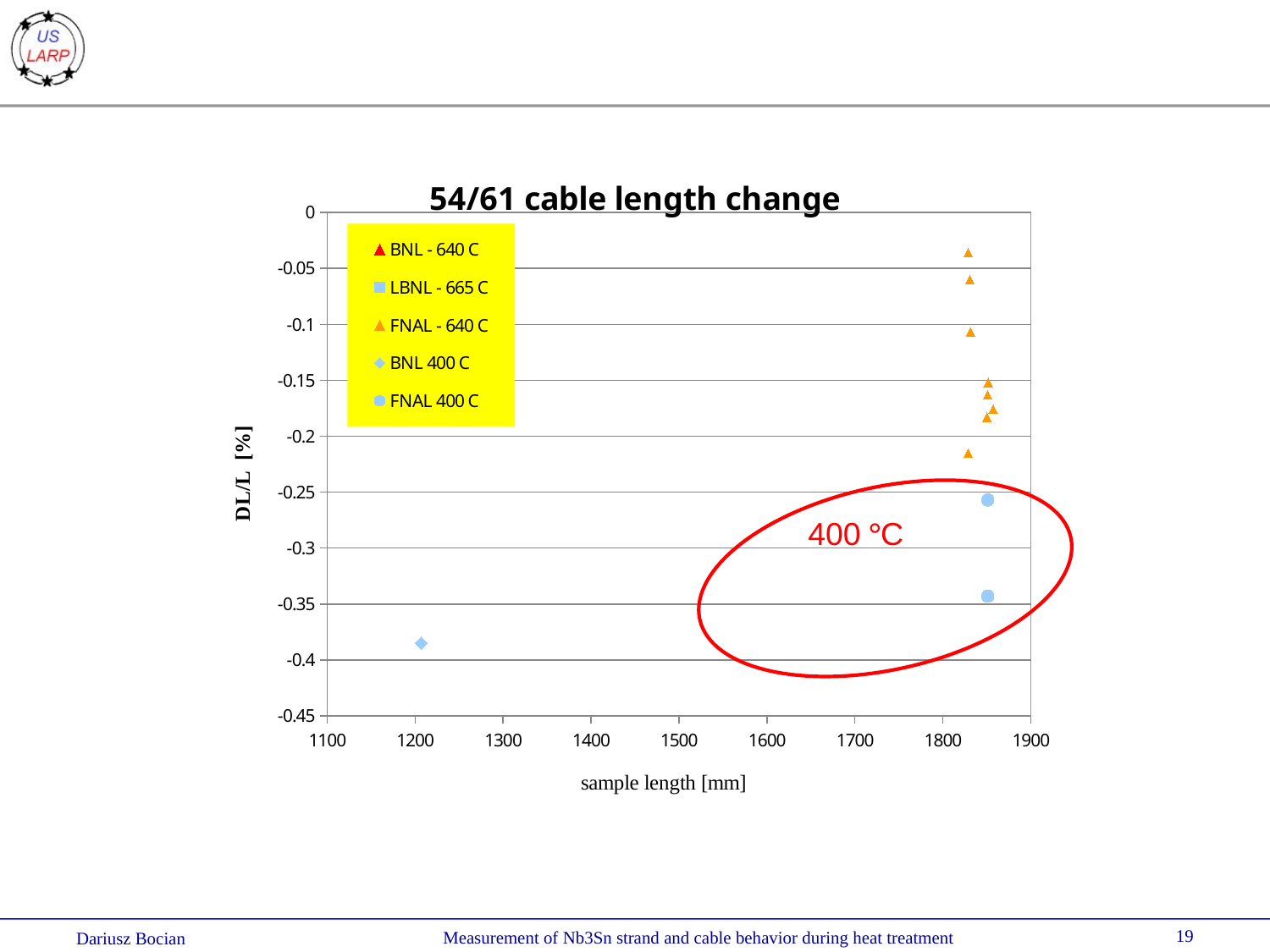
How many BNL 400 C points are plotted? 1 Is the DL/L value for the upper FNAL 400 C point greater or less than -0.3? greater Is the DL/L value for the BNL 400 C point greater or less than -0.35? less Is the highest FNAL - 640 C point greater or less than -0.05 in DL/L? greater Which series has the point with the smallest sample length? BNL 400 C How many FNAL 400 C points are plotted? 2 Which has the larger DL/L value: the BNL 400 C point or the lower FNAL 400 C point? the lower FNAL 400 C point What is the label of the x axis? sample length [mm] What kind of chart is shown on the slide? scatter chart What is the title of the chart? 54/61 cable length change How many series does the legend list? 5